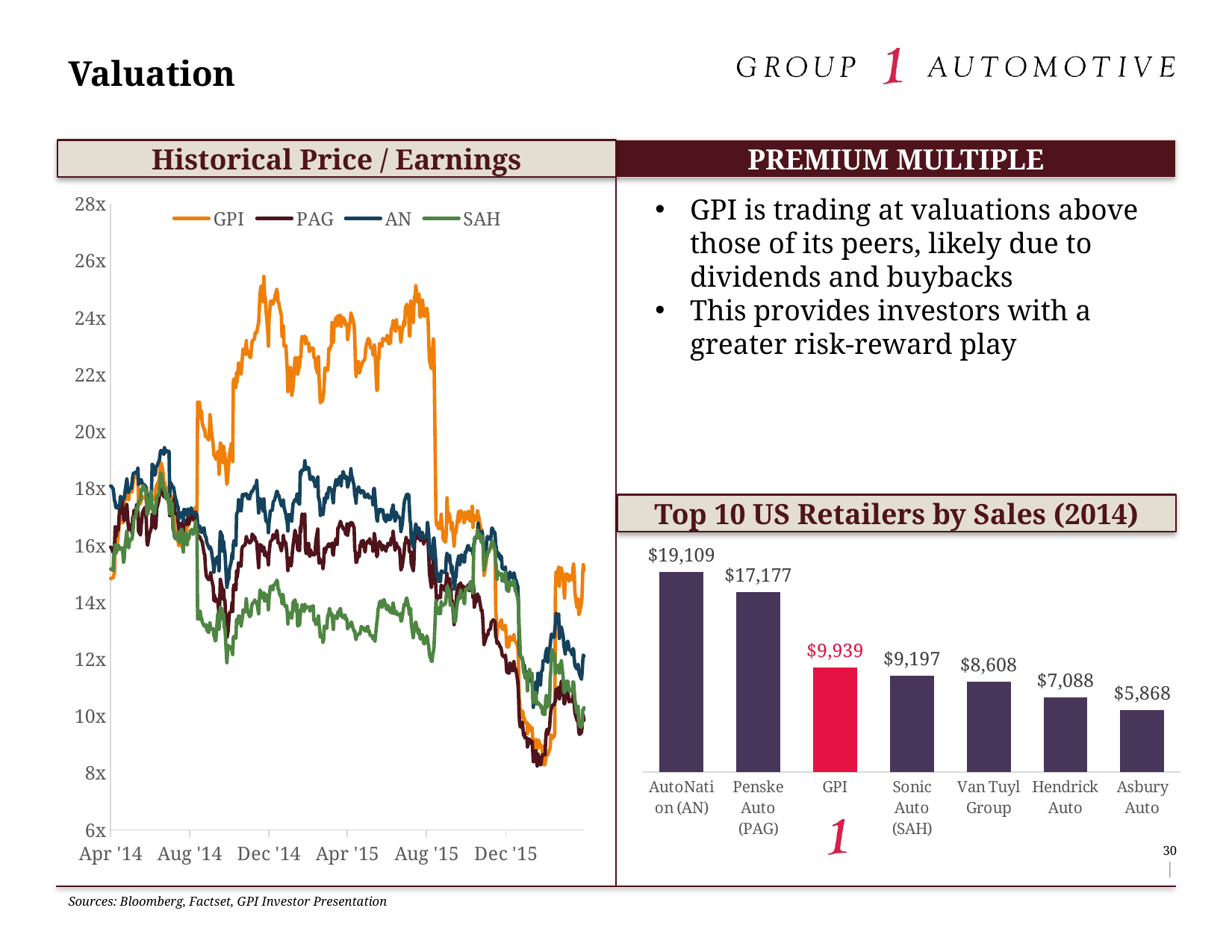
In the 'Top 10 US Retailers by Sales (2014)' chart, what is the difference between AutoNation (AN) and Penske Auto (PAG)? $1,932 In the 'Top 10 US Retailers by Sales (2014)' chart, what is the value for GPI? $9,939 What kind of chart is the 'Top 10 US Retailers by Sales (2014)' chart? Bar chart How many series does the legend of the 'Historical Price / Earnings' chart list? 4 In the 'Top 10 US Retailers by Sales (2014)' chart, what is the value for Penske Auto (PAG)? $17,177 In the 'Top 10 US Retailers by Sales (2014)' chart, which retailer has the lowest sales? Asbury Auto In the 'Top 10 US Retailers by Sales (2014)' chart, which is larger, GPI or Sonic Auto (SAH)? GPI In the 'Top 10 US Retailers by Sales (2014)' chart, which retailer has the highest sales? AutoNation (AN) In the 'Top 10 US Retailers by Sales (2014)' chart, which bar is highlighted in a different colour (red) from the others? GPI What kind of chart is the 'Historical Price / Earnings' chart? Line chart How many retailers are shown in the 'Top 10 US Retailers by Sales (2014)' chart? 7 In the 'Historical Price / Earnings' chart, is the GPI value around Dec '14 greater or less than 20x? greater